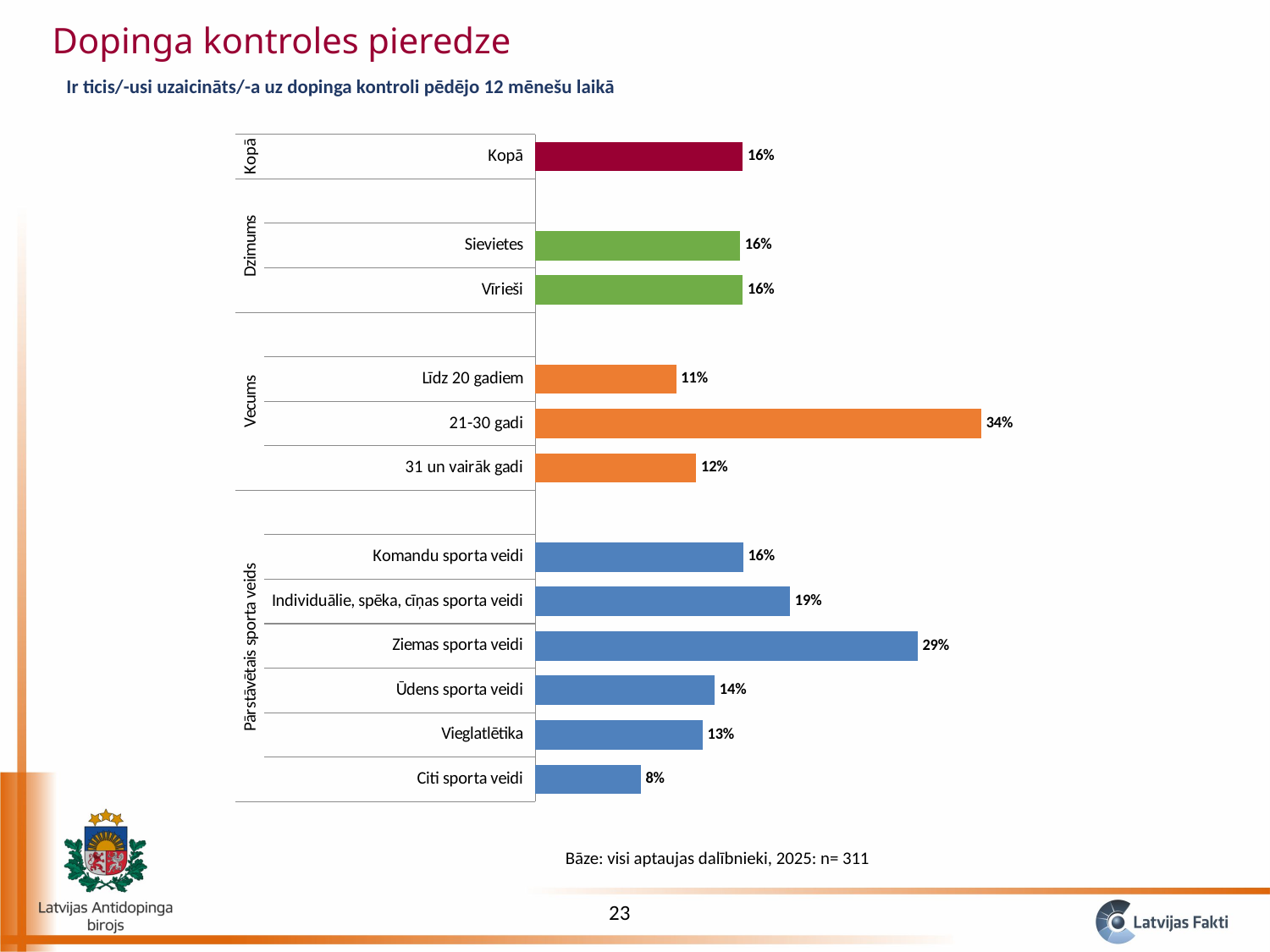
What is the difference between the values for Ziemas sporta veidi and Komandu sporta veidi? 13% Which category has the lowest value? Citi sporta veidi How many categories are plotted in the chart? 12 What is the value for 21-30 gadi? 34% Which category has the highest value? 21-30 gadi What kind of chart is shown on the slide? Bar chart What is the value for Citi sporta veidi? 8% What is the value for Kopā? 16% What is the base (n) stated below the chart? n= 311 What is the value for Ziemas sporta veidi? 29% What is the difference between the values for 21-30 gadi and Līdz 20 gadiem? 23% Which is larger, the value for Ūdens sporta veidi or Vieglatlētika? Ūdens sporta veidi